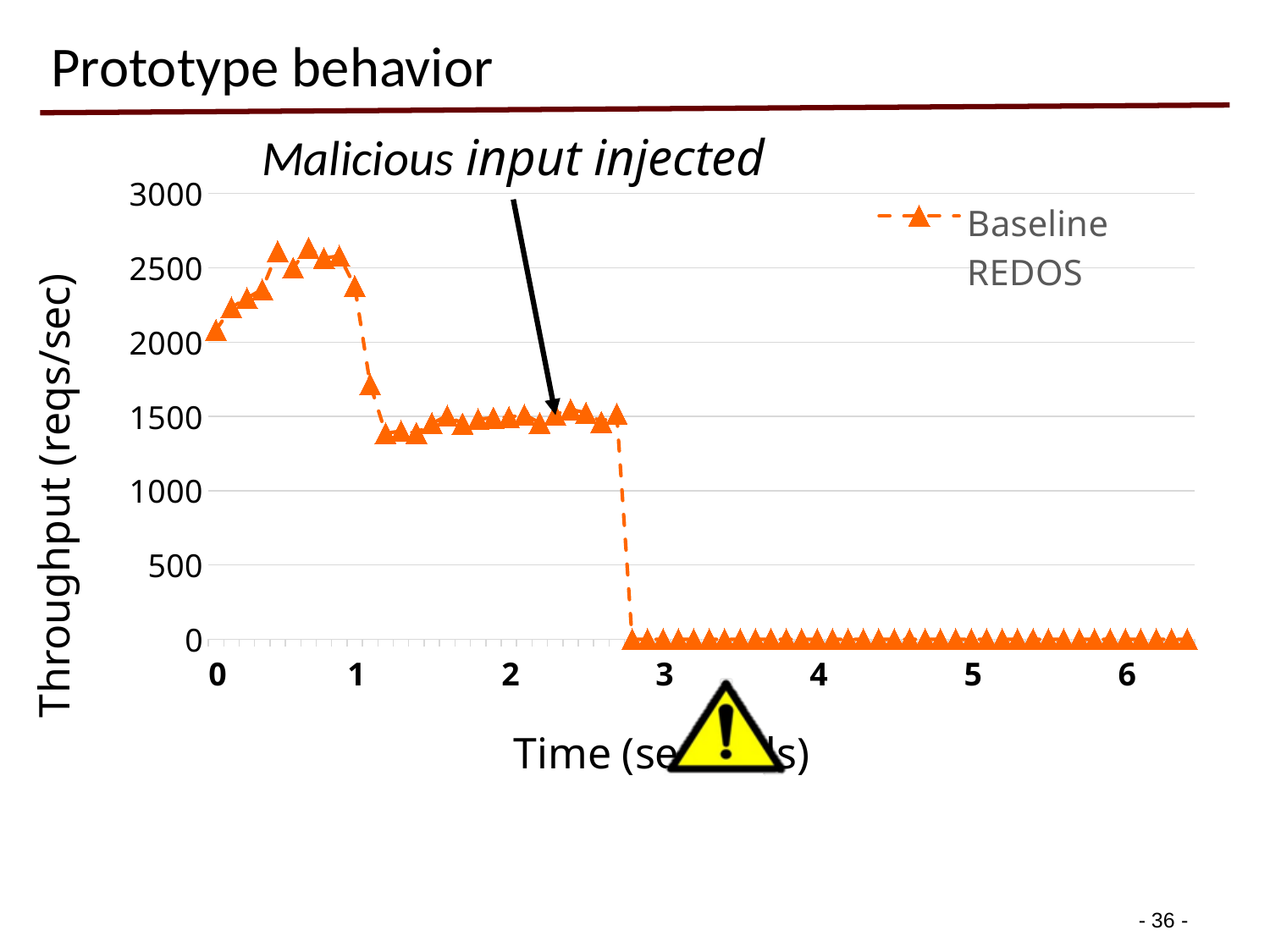
What is the name of the series shown in the legend? Baseline REDOS What kind of chart is shown on the slide? line chart Is the throughput at time 1 larger or smaller than the throughput at time 2? larger Overall, do the throughput values rise or fall as time increases along the x axis? fall Is the throughput value at time 5 greater or less than 1000? less Is the throughput value at time 2 greater or less than 1000? greater Is the throughput value at time 4 greater or less than 500? less Is the throughput at time 4 larger or smaller than the throughput at time 2? smaller What is the label of the y axis? Throughput (reqs/sec) How many series does the legend list? 1